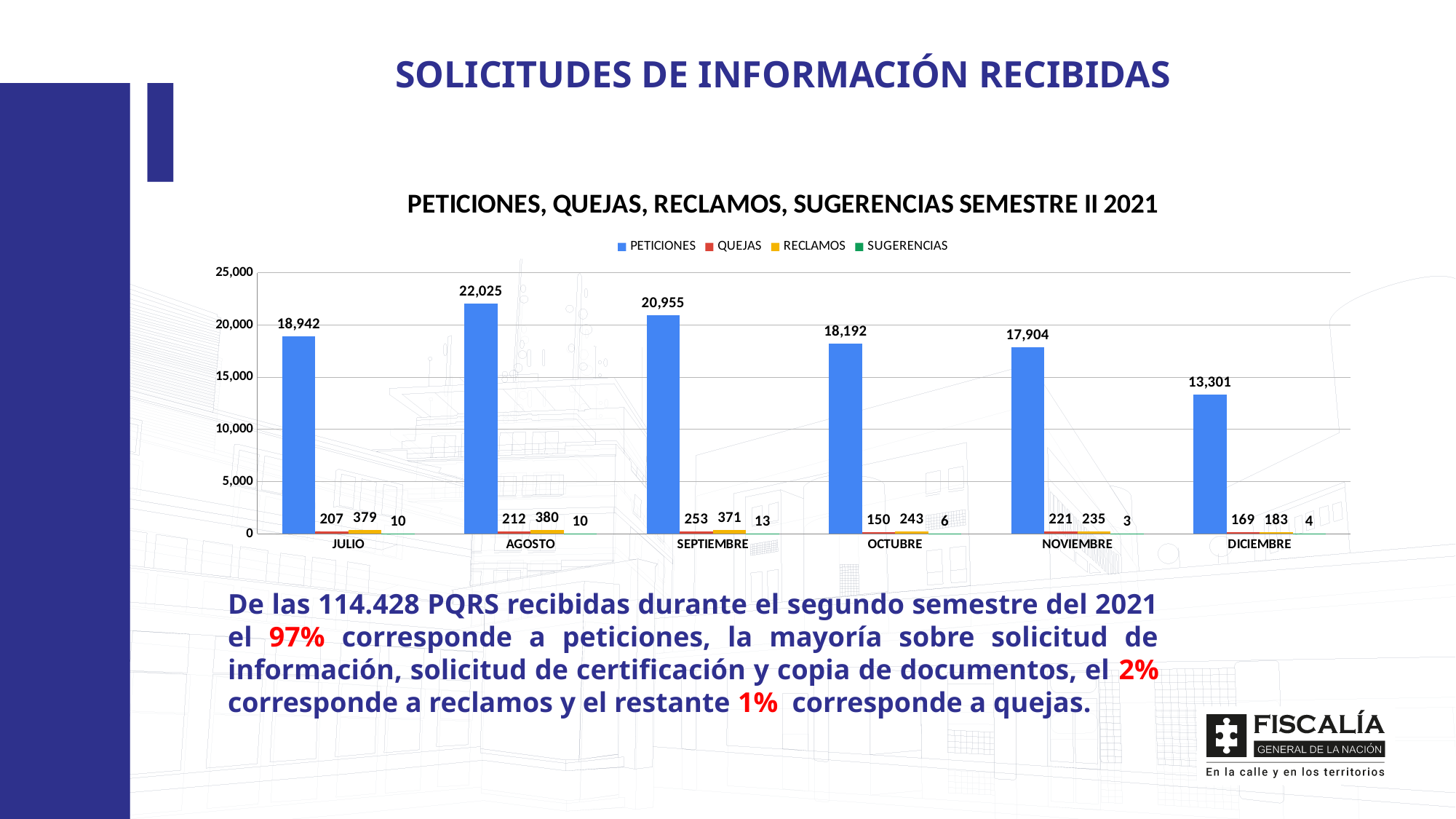
What is the value of RECLAMOS for JULIO? 379 What is the value of SUGERENCIAS for SEPTIEMBRE? 13 Which month has the lowest value for PETICIONES? DICIEMBRE How many months are shown on the x axis? 6 Which month has the highest value for PETICIONES? AGOSTO What is the value of PETICIONES for AGOSTO? 22,025 How many series does the legend list? 4 What kind of chart is shown? Bar chart What is the title of the chart? PETICIONES, QUEJAS, RECLAMOS, SUGERENCIAS SEMESTRE II 2021 Which is larger, the QUEJAS value for NOVIEMBRE or the QUEJAS value for DICIEMBRE? NOVIEMBRE What is the value of QUEJAS for OCTUBRE? 150 What is the difference between the PETICIONES values for AGOSTO and DICIEMBRE? 8,724